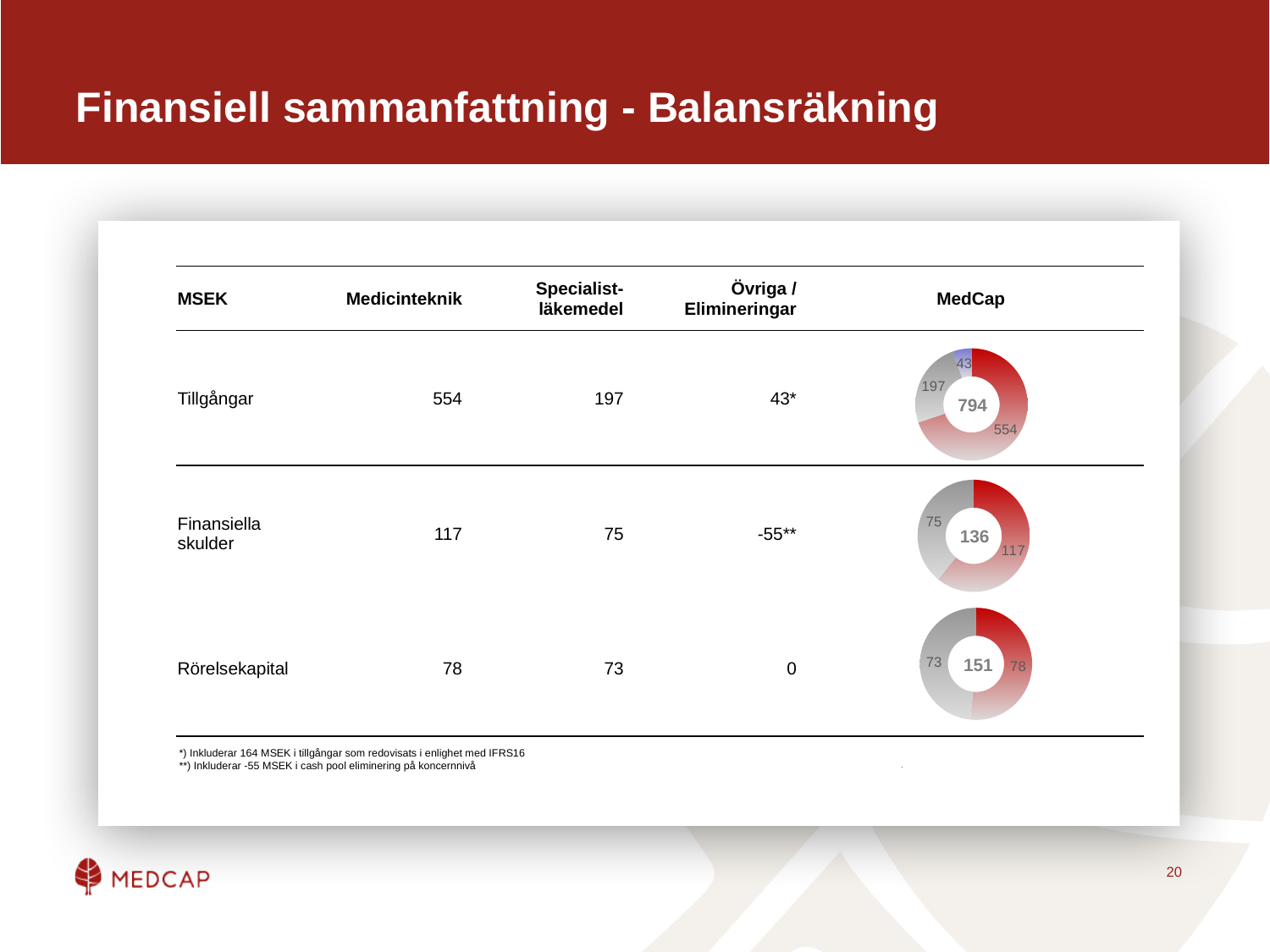
In the Finansiella skulder donut chart, what is the value shown in the centre? 136 What type of chart is shown in the MedCap column for the Tillgångar row? Donut chart In the Rörelsekapital donut chart, what is the value of the red slice? 78 In the Tillgångar donut chart, what is the difference between the 554 slice and the 197 slice? 357 In the Rörelsekapital donut chart, what is the value shown in the centre? 151 How many slices does the Rörelsekapital donut chart have? 2 In the Tillgångar donut chart, what is the value of the largest slice? 554 In the Tillgångar donut chart, what is the value of the smallest slice? 43 In the Finansiella skulder donut chart, what is the difference between the two slices, 117 and 75? 42 In the Tillgångar donut chart, what is the value shown in the centre? 794 How many slices does the Tillgångar donut chart have? 3 In the Finansiella skulder donut chart, which slice is larger, 117 or 75? 117